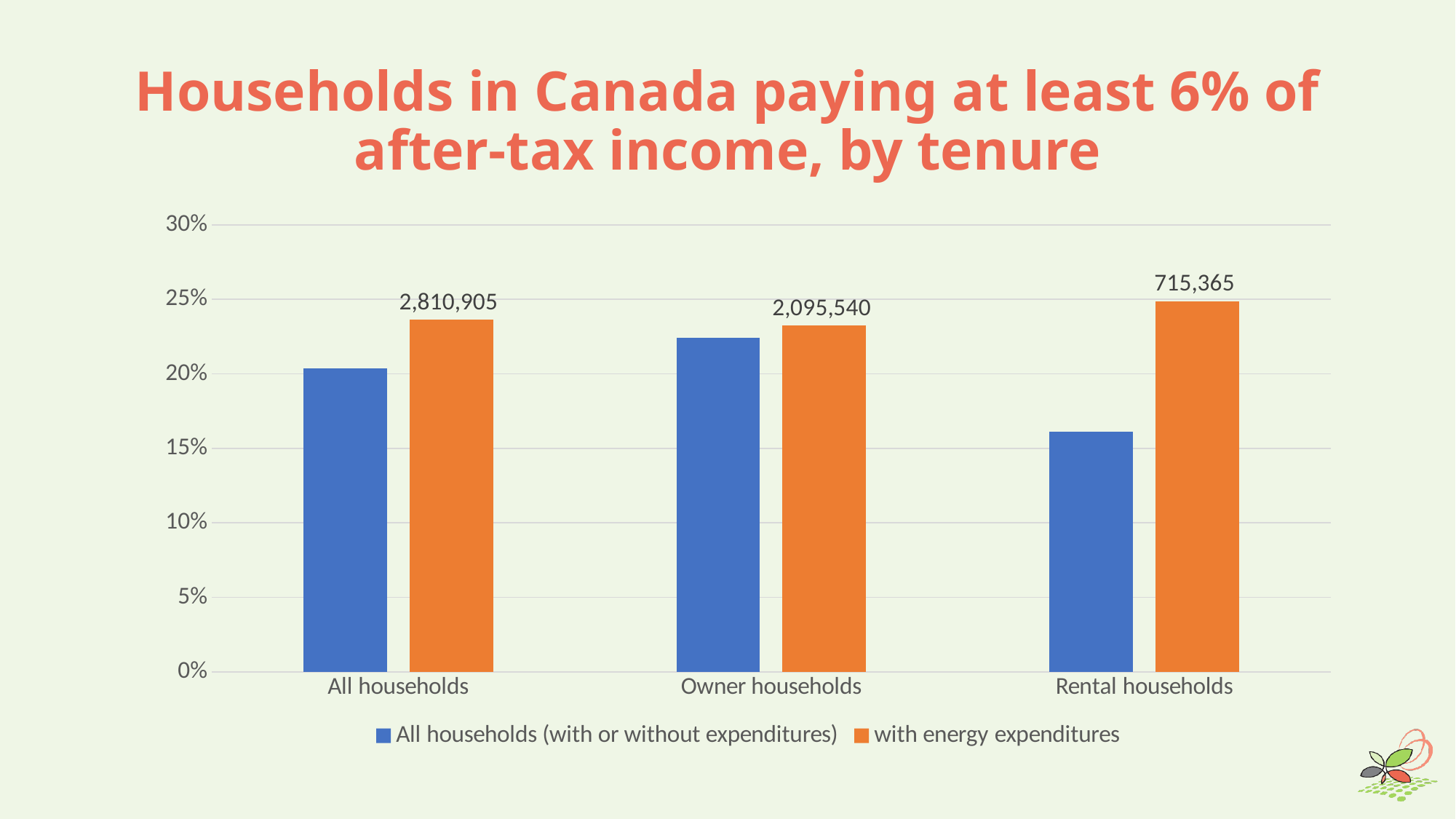
Which category has the shortest 'All households (with or without expenditures)' bar? Rental households How many series does the legend list? 2 What is the title of the chart? Households in Canada paying at least 6% of after-tax income, by tenure Which category has the tallest 'with energy expenditures' bar? Rental households What data label is printed on the 'with energy expenditures' bar for Rental households? 715,365 What data label is printed on the 'with energy expenditures' bar for Owner households? 2,095,540 What type of chart is shown on the slide? Bar chart How many tenure categories are shown along the x axis? 3 For Rental households, which series has the larger value: 'All households (with or without expenditures)' or 'with energy expenditures'? with energy expenditures What data label is printed on the 'with energy expenditures' bar for All households? 2,810,905 Is the 'All households (with or without expenditures)' value for Owner households greater or less than 20%? greater Is the 'All households (with or without expenditures)' value for Rental households greater or less than 20%? less